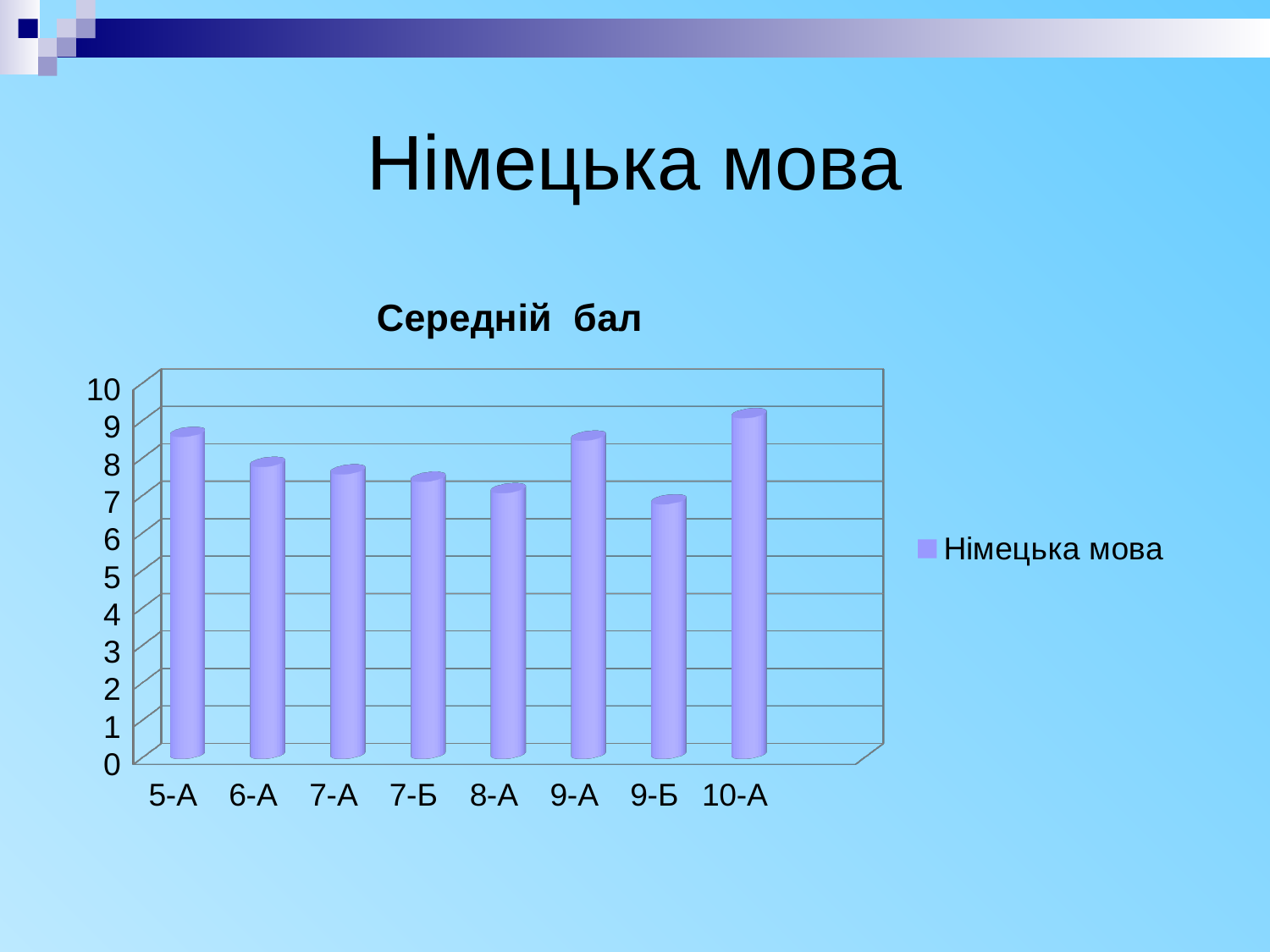
Which class has the larger value, 5-А or 6-А? 5-А Is the value for 5-А greater or less than 8? greater What kind of chart is shown on the slide? bar chart Is the value for 9-Б greater or less than 8? less Which class has the lowest average score? 9-Б What is the name of the series shown in the legend? Німецька мова What is the title of the chart? Середній бал Is the value for 10-А greater or less than 8? greater How many series does the legend list? 1 Which class has the larger value, 9-А or 9-Б? 9-А Which class has the highest average score? 10-А How many classes (categories) are shown on the x axis? 8